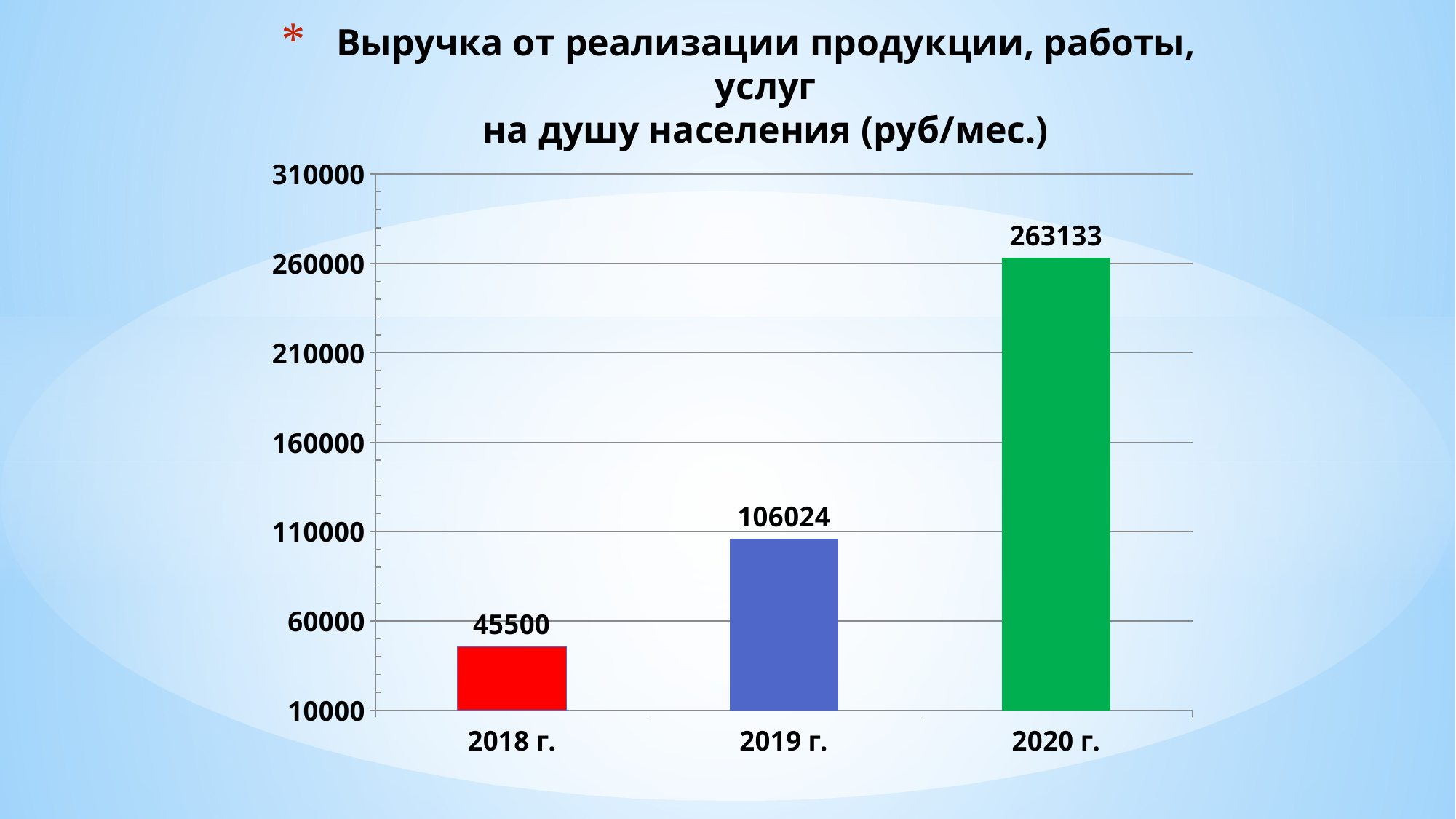
Which year has the lowest value? 2018 г. Do the values rise or fall from 2018 г. to 2020 г.? rise What is the difference between the values for 2019 г. and 2018 г.? 60524 What kind of chart is shown on the slide? bar chart What is the value for 2018 г.? 45500 What is the value for 2020 г.? 263133 Is the value for 2020 г. greater or less than 260000? greater What is the difference between the values for 2020 г. and 2019 г.? 157109 What is the value for 2019 г.? 106024 Which year has the highest value? 2020 г. Which is larger, the value for 2019 г. or the value for 2018 г.? 2019 г. How many years are shown on the chart? 3